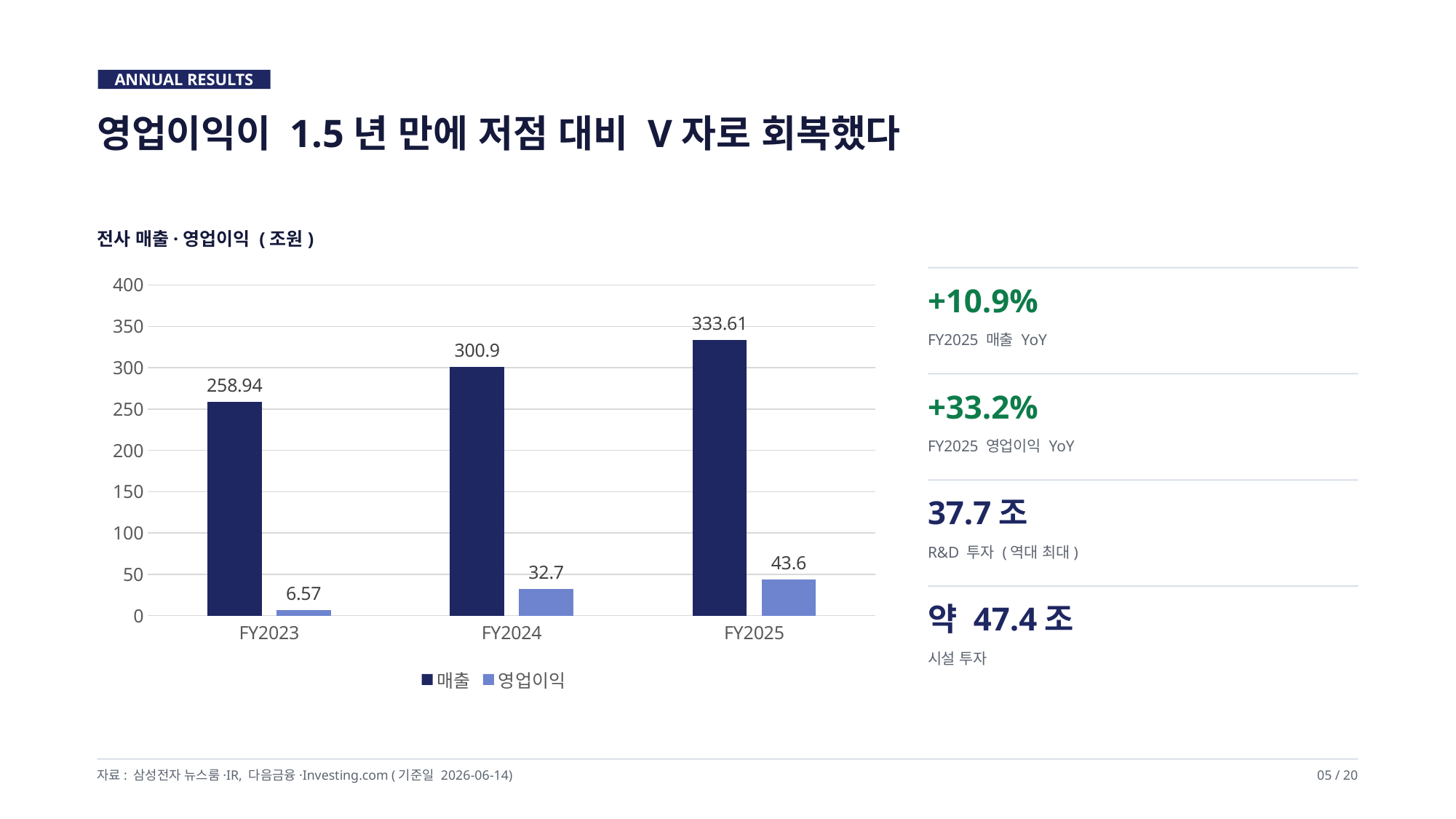
Which fiscal year has the lowest 영업이익? FY2023 Which is larger, 매출 in FY2023 or 매출 in FY2024? FY2024 Which fiscal year has the highest 매출? FY2025 What kind of chart is shown on the slide? Bar chart What is the 매출 value for FY2024? 300.9 How many series does the legend list? 2 What is the difference between 매출 in FY2025 and FY2024? 32.71 What is the 영업이익 value for FY2025? 43.6 What is the 영업이익 value for FY2023? 6.57 Does 영업이익 rise or fall from FY2023 to FY2025? Rise What is the difference between 영업이익 in FY2025 and FY2024? 10.9 How many fiscal years are shown on the x axis? 3